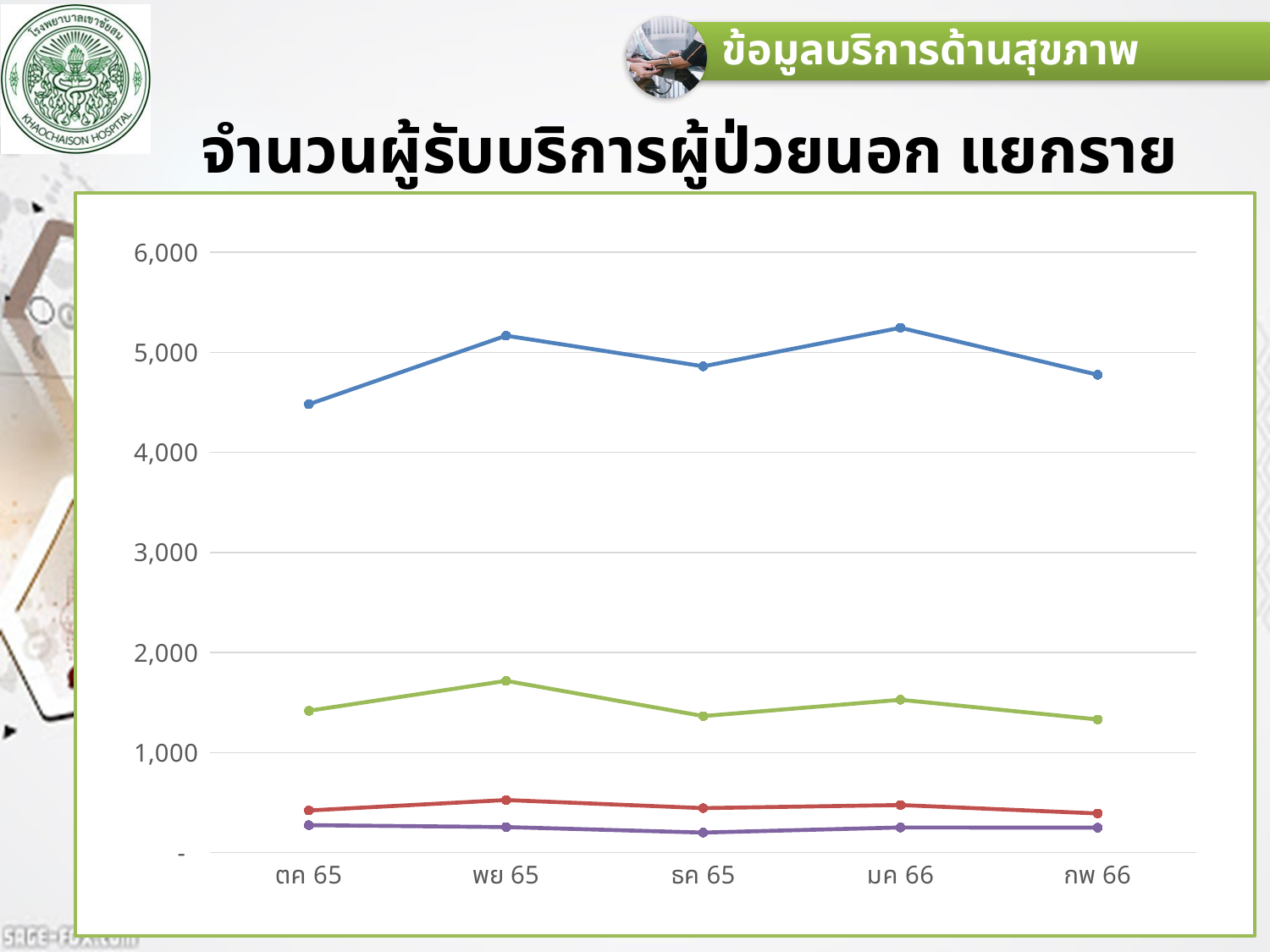
At which category does the green line reach its highest value? พย 65 How many lines are plotted on the chart? 4 What is the first category label on the x axis? ตค 65 At which category does the blue line reach its lowest value? ตค 65 Is the value of the green line at พย 65 greater or less than 1,500? greater How many categories are shown on the x axis of the chart? 5 Which line has the larger value at ธค 65, the blue line or the green line? the blue line Does the blue line rise or fall from มค 66 to กพ 66? fall Is the value of the red line at ตค 65 greater or less than 1,000? less Is the value of the blue line at พย 65 greater or less than 5,000? greater What kind of chart is shown on the slide? line chart